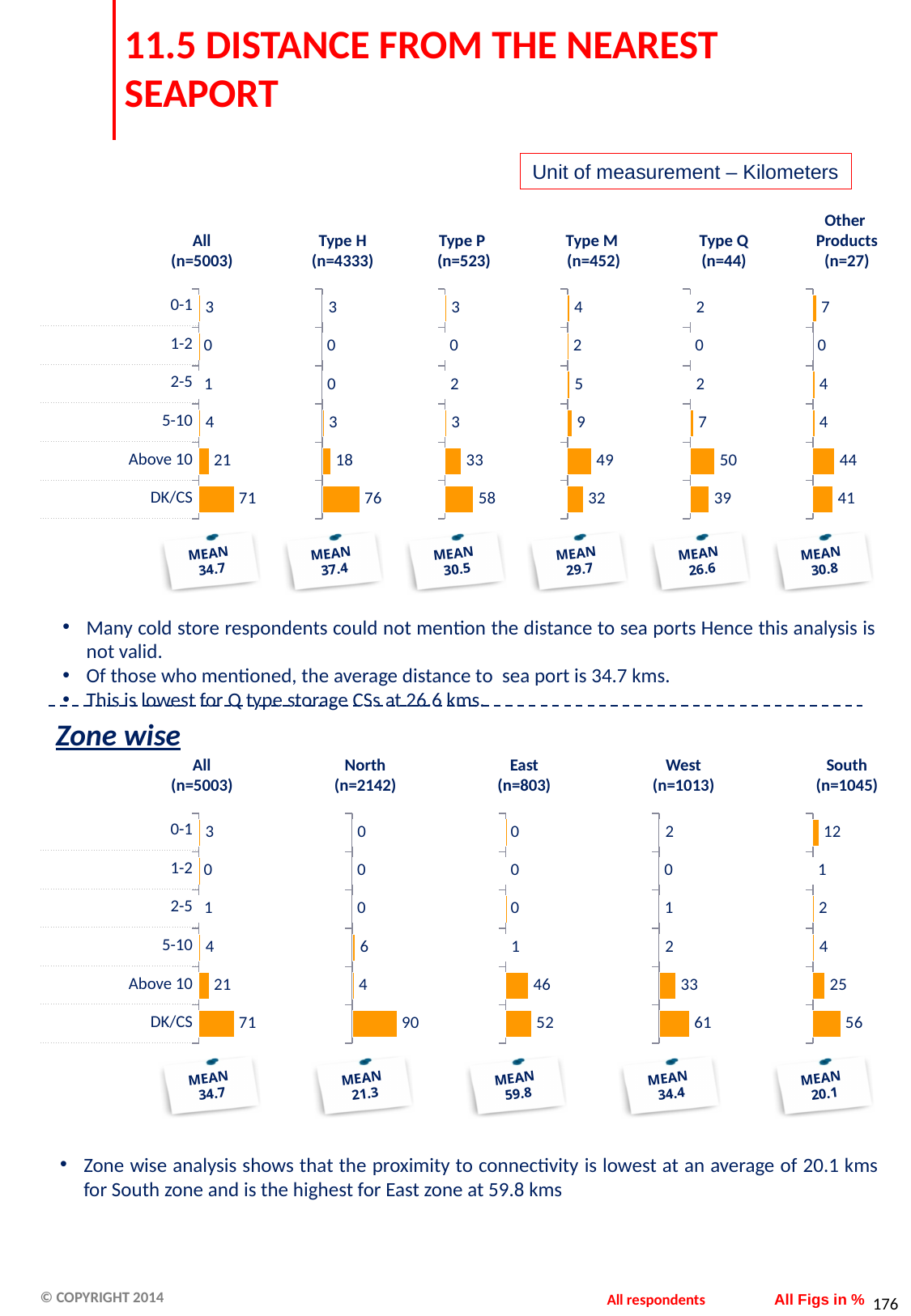
In the Zone wise East (n=803) chart, which distance category has the highest value? DK/CS In the Zone wise South (n=1045) chart, what is the total of all six category values? 100 In the Zone wise section, which is larger: the Above 10 value for East or the Above 10 value for West? East In the Zone wise section, what is the value for the 0-1 category in the South (n=1045) chart? 12 What unit of measurement is stated for the charts on this slide? Kilometers In the top section Type M (n=452) chart, what is the difference between the Above 10 value and the DK/CS value? 17 In the Zone wise section, what is the DK/CS value in the North (n=2142) chart? 90 In the top section (by type), what is the DK/CS value in the Type H (n=4333) chart? 76 How many distance categories are shown in each of the small charts on the slide? 6 In the top section, what is the Above 10 value in the Other Products (n=27) chart? 44 In the top section Type P (n=523) chart, how much larger is the DK/CS value than the Above 10 value? 25 What kind of chart is used for the distance distributions on this slide? Bar chart